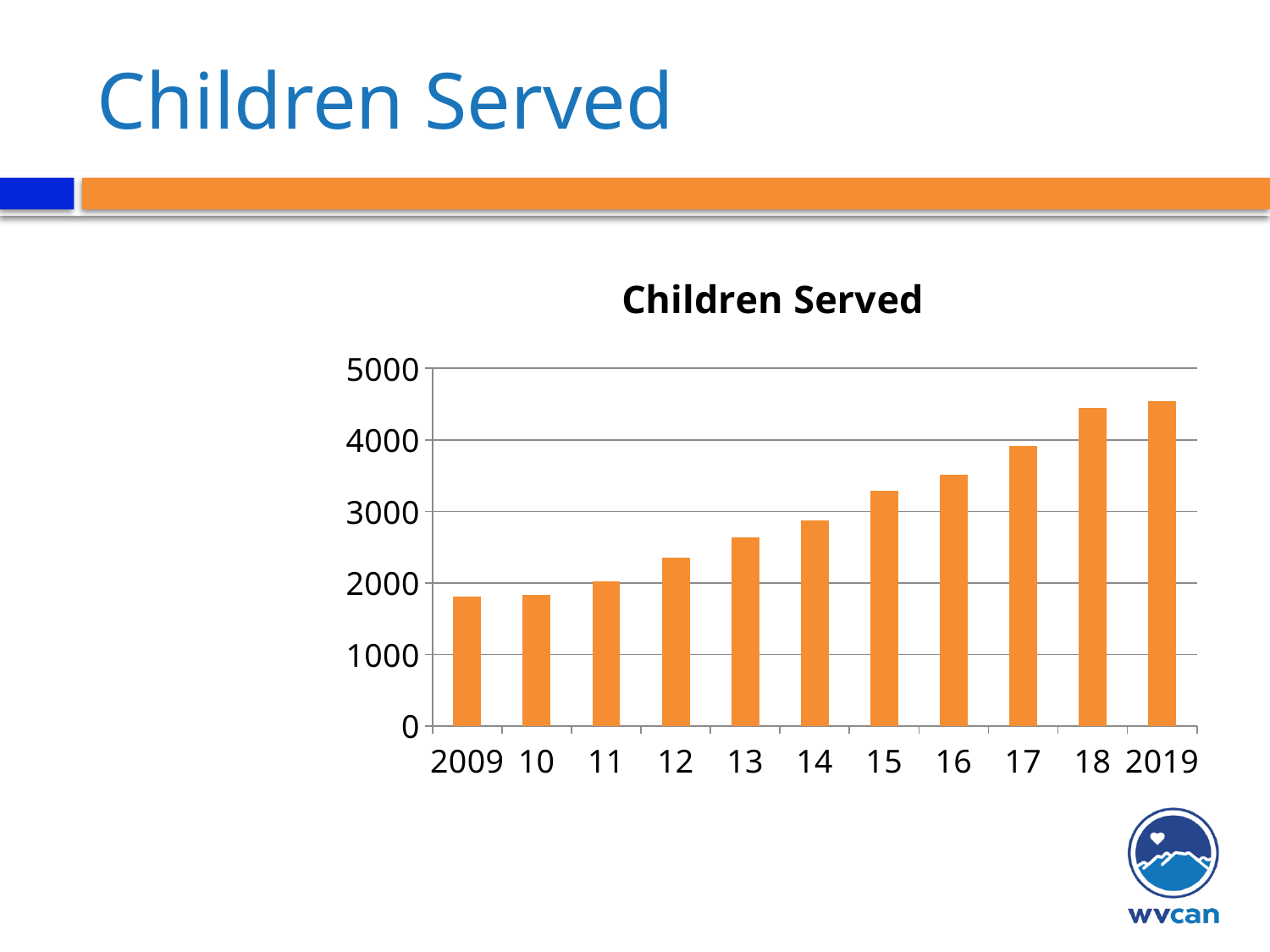
Is the value for 15 greater or less than 3000? greater Is the value for 2019 greater or less than 4000? greater Is the value for 2009 greater or less than 2000? less What is the title of the chart? Children Served How many years (bars) are shown in the Children Served chart? 11 Which year has the highest number of children served? 2019 Do the values generally rise or fall from 2009 to 2019? rise Which is larger, the value for 14 or the value for 17? 17 What colour are the bars in the chart? orange What kind of chart is shown on the slide? bar chart